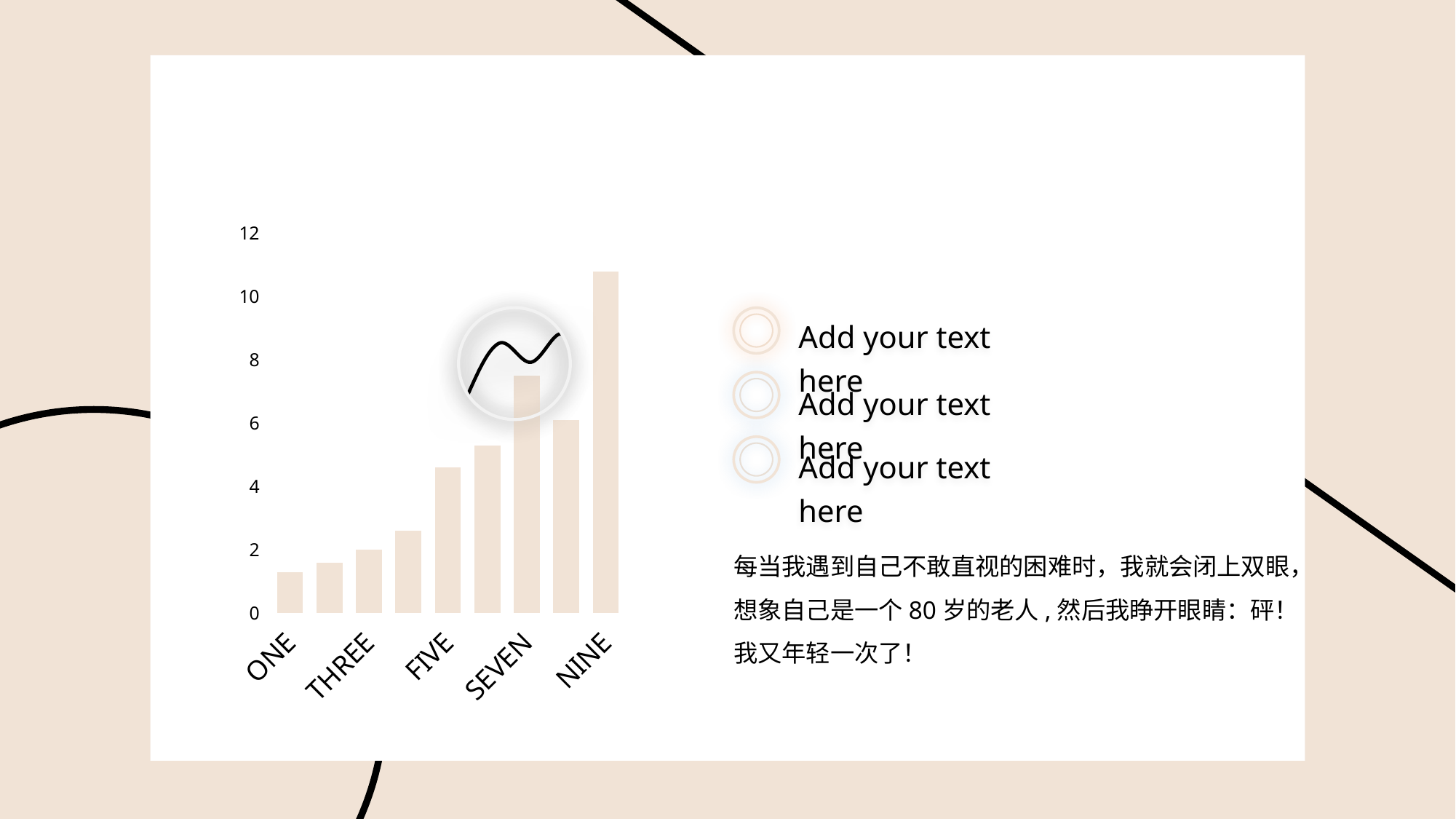
Is the value for ONE greater or less than 2? less Which category has the highest bar? NINE Is the value for SEVEN greater or less than 6? greater Which category has the lowest bar? ONE Which is larger, the value for FIVE or the value for THREE? FIVE Is the value for FIVE greater or less than 4? greater What is the highest value shown on the vertical axis? 12 Which is larger, the value for NINE or the value for SEVEN? NINE How many bars does the chart contain? 9 What kind of chart is shown on the slide? bar chart What is the first category label on the horizontal axis? ONE